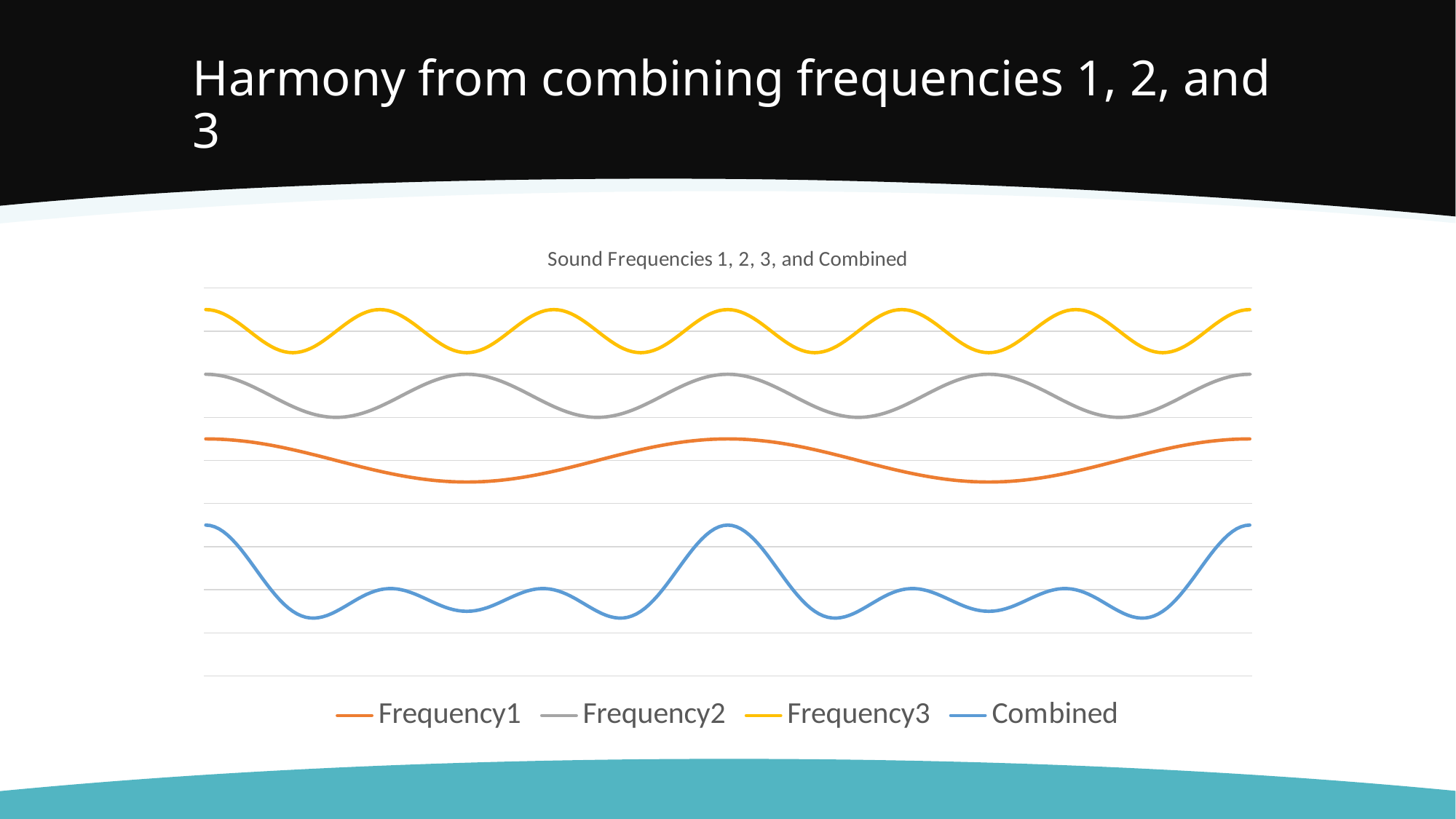
How many series does the legend list? 4 Which colour is used for the Combined series? Blue What kind of chart is shown on the slide? Line chart What is the title of the chart? Sound Frequencies 1, 2, 3, and Combined Which series oscillates the most times across the x axis? Frequency3 How many full peaks does the Frequency1 line reach between its start and end points? 1 Which series oscillates the fewest times across the x axis? Frequency1